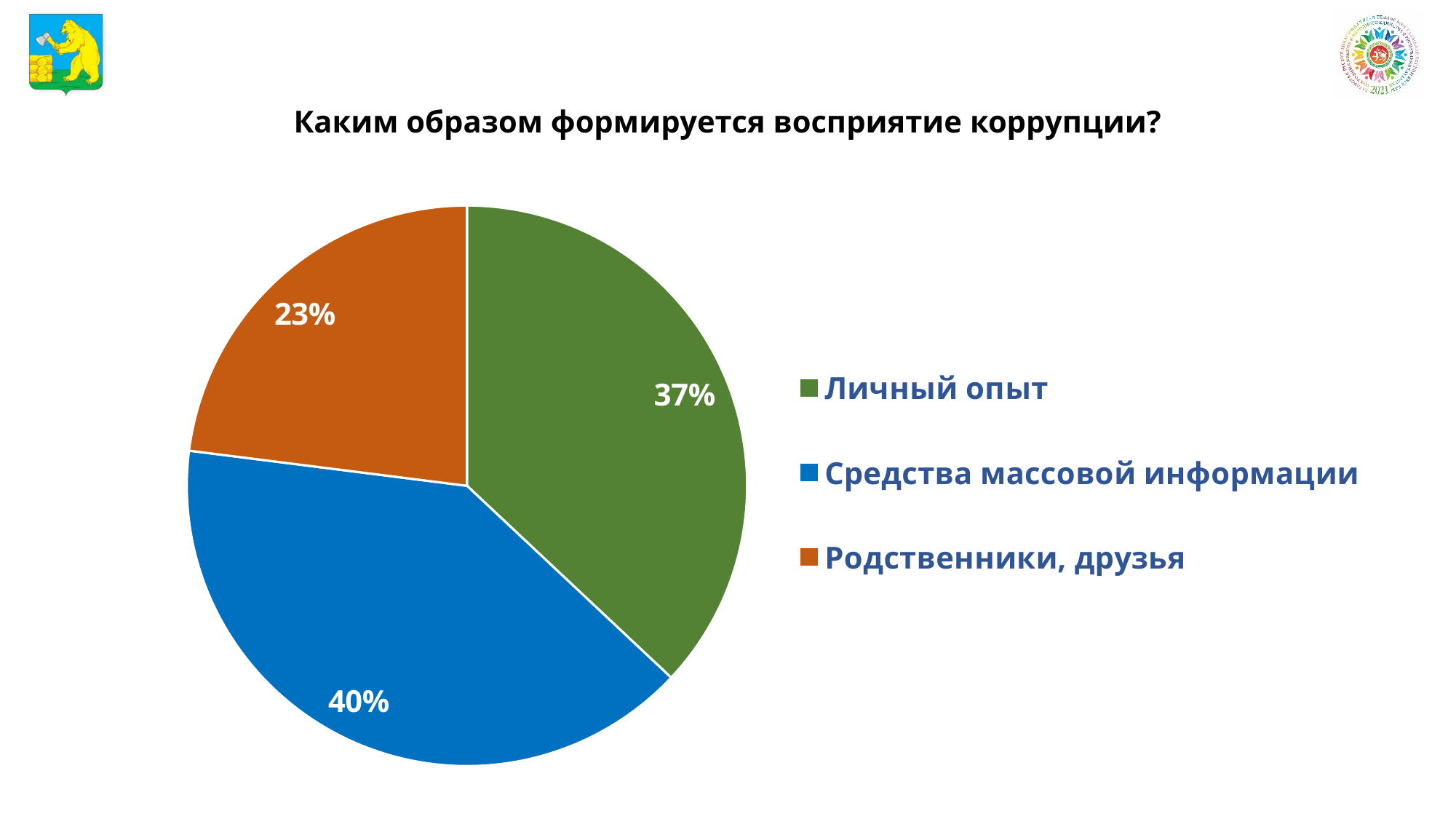
What is the title of the chart? Каким образом формируется восприятие коррупции? What is the value for Средства массовой информации? 40% Which colour represents Средства массовой информации in the chart? Blue Which is larger: Личный опыт or Родственники, друзья? Личный опыт Which category has the smallest share of the pie? Родственники, друзья What is the difference between the values for Личный опыт and Родственники, друзья? 14% Which category has the largest share of the pie? Средства массовой информации How many slices does the pie chart have? 3 What is the value for Родственники, друзья? 23% What is the difference between the values for Средства массовой информации and Родственники, друзья? 17% What is the value for Личный опыт? 37% What type of chart is shown on the slide? Pie chart